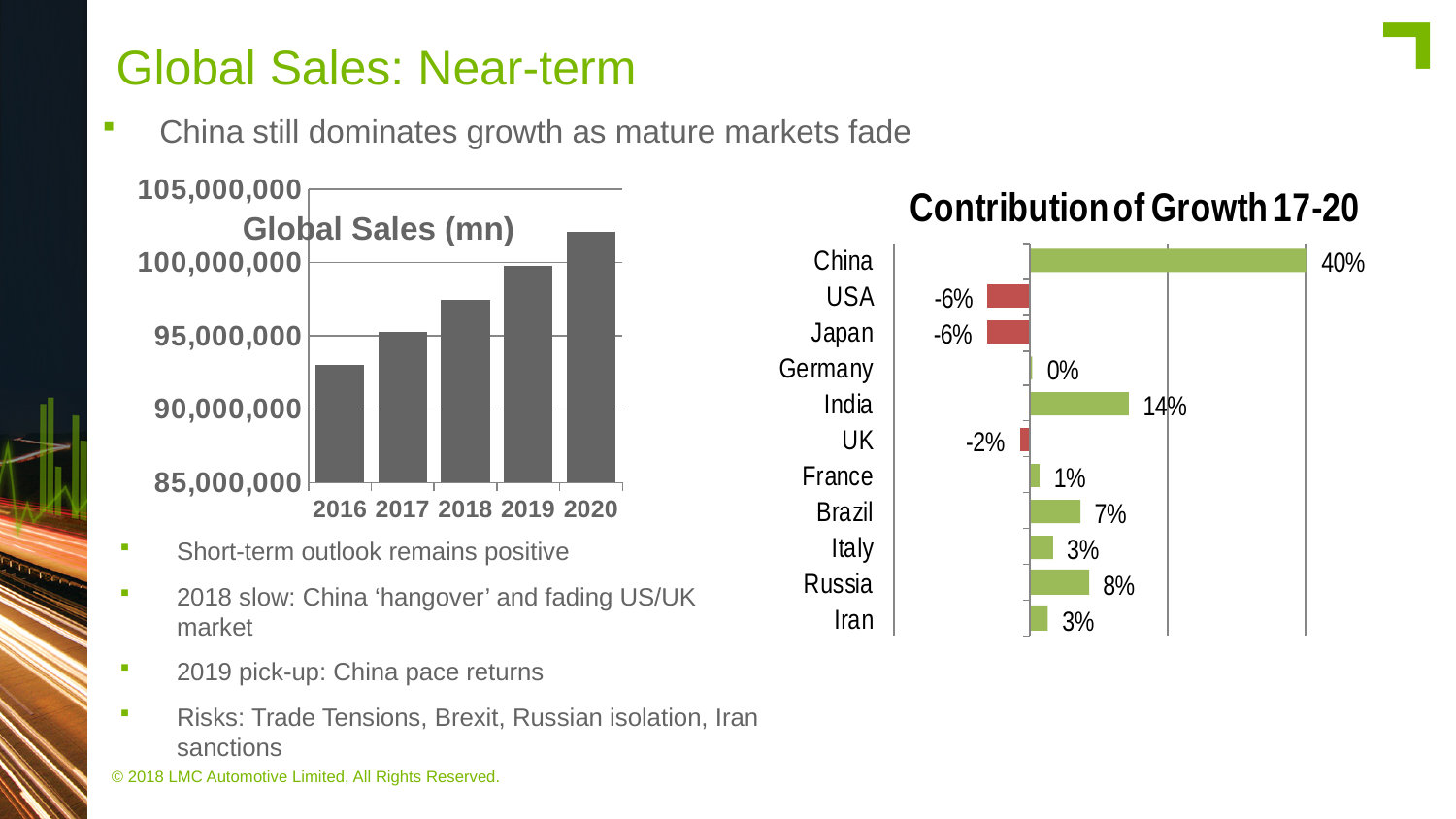
In the Global Sales (mn) chart, do the values rise or fall from 2016 to 2020? rise In the Contribution of Growth 17-20 chart, how many countries are listed? 11 In the Global Sales (mn) chart, which year has the highest value? 2020 In the Global Sales (mn) chart, is the value for 2016 greater or less than 95,000,000? less In the Global Sales (mn) chart, is the value for 2020 greater or less than 100,000,000? greater In the Global Sales (mn) chart, how many years are shown on the x axis? 5 In the Contribution of Growth 17-20 chart, which country has the highest value? China What type of chart is the Global Sales (mn) chart? bar chart In the Contribution of Growth 17-20 chart, what is the value for China? 40% In the Contribution of Growth 17-20 chart, what is the value for India? 14% In the Contribution of Growth 17-20 chart, what is the difference between the values for China and India? 26% In the Contribution of Growth 17-20 chart, what is the value for the UK? -2%